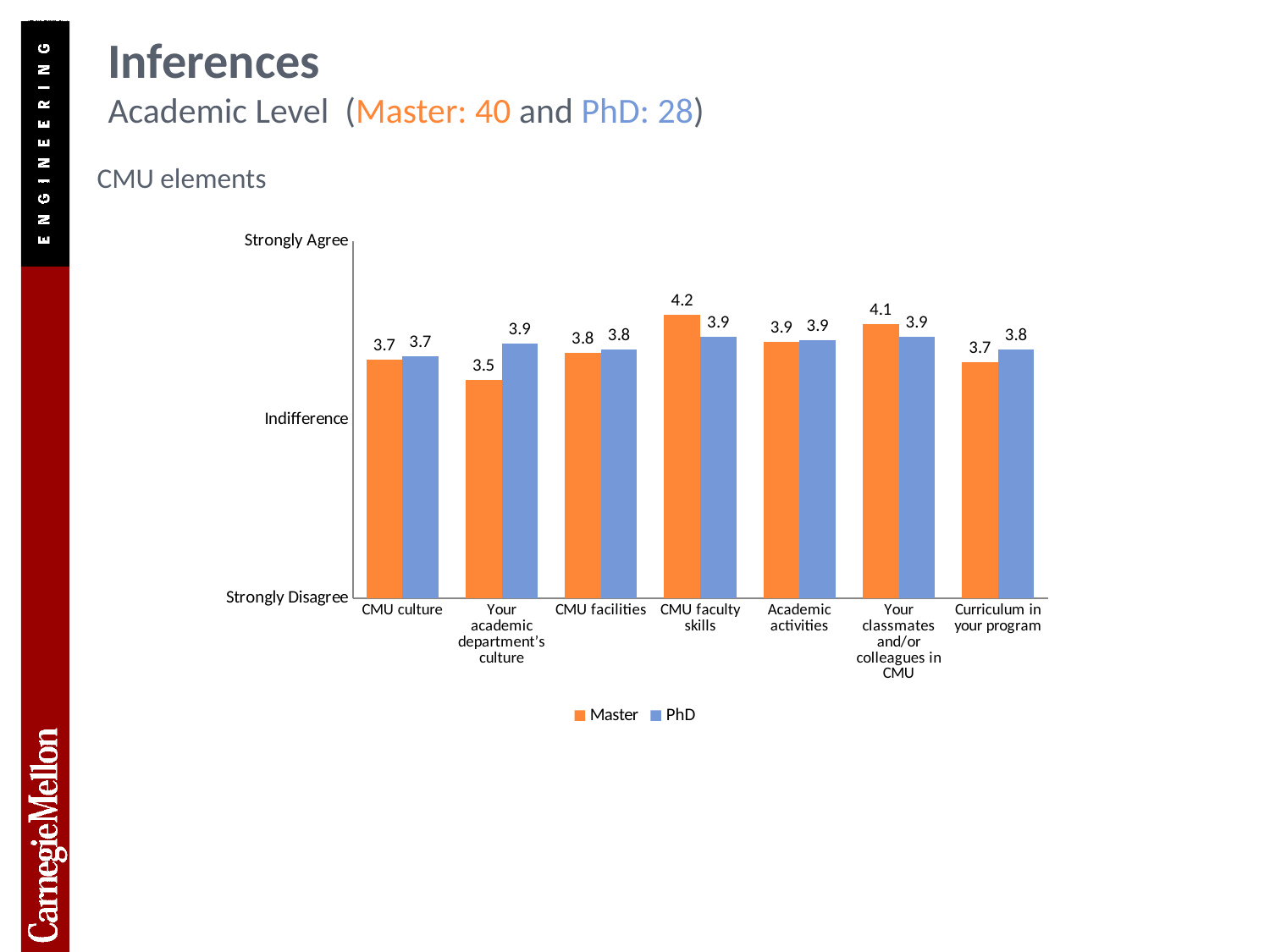
Which colour represents the PhD series in the chart? Blue For Your classmates and/or colleagues in CMU, which series has the larger value, Master or PhD? Master What is the PhD value for Your academic department's culture? 3.9 How many categories are shown on the x axis? 7 Which category has the highest Master value? CMU faculty skills How many series does the legend list? 2 What is the difference between the Master and PhD values for Your academic department's culture? 0.4 Which category has the lowest Master value? Your academic department's culture What kind of chart is shown on the slide? Bar chart What is the difference between the Master and PhD values for CMU faculty skills? 0.3 What is the Master value for CMU faculty skills? 4.2 What is the Master value for Curriculum in your program? 3.7